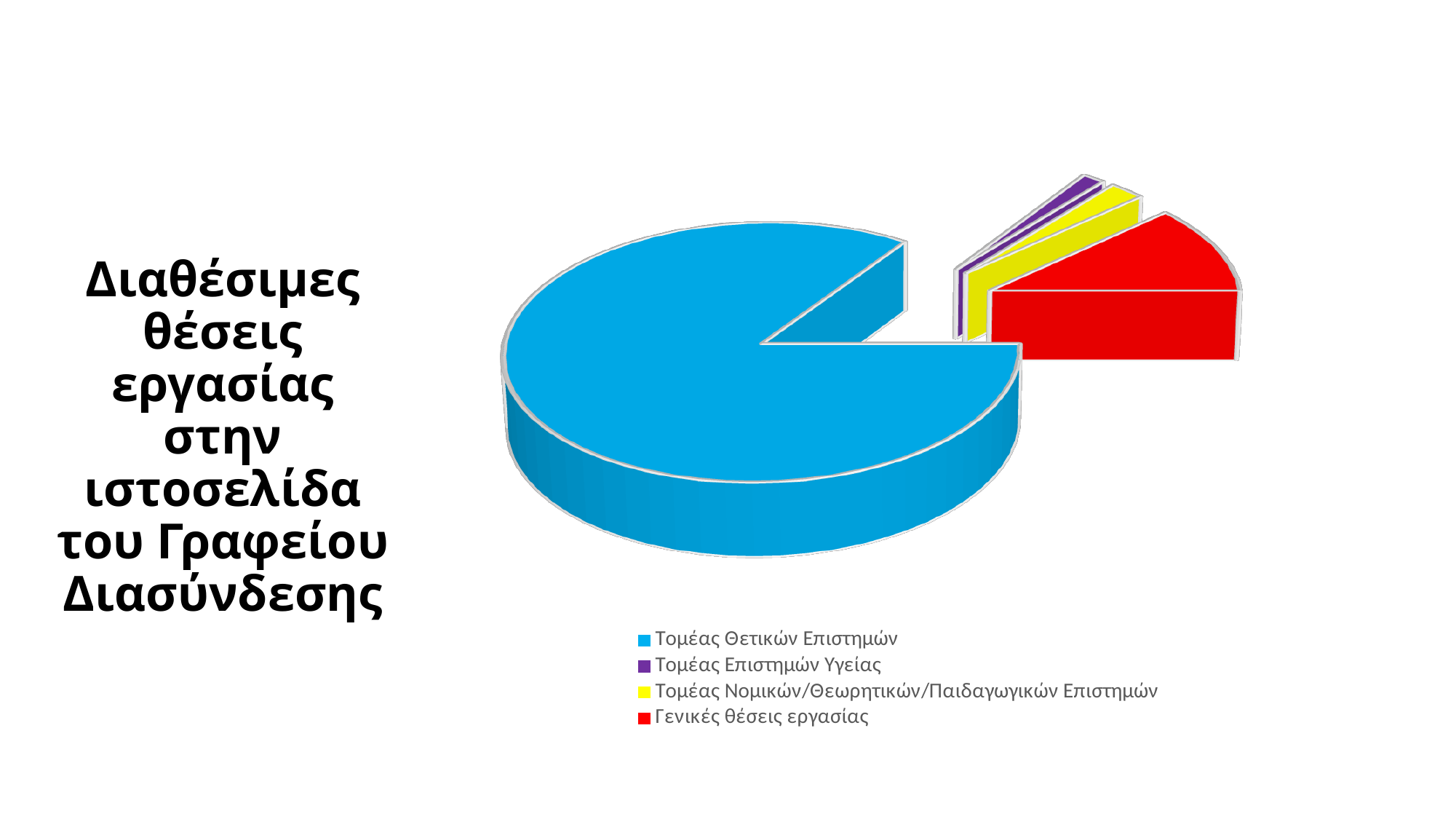
Which slice is larger: Γενικές θέσεις εργασίας or Τομέας Επιστημών Υγείας? Γενικές θέσεις εργασίας Which slice is larger: Γενικές θέσεις εργασίας or Τομέας Νομικών/Θεωρητικών/Παιδαγωγικών Επιστημών? Γενικές θέσεις εργασίας Which category has the largest slice of the pie? Τομέας Θετικών Επιστημών Which slice is larger: Τομέας Θετικών Επιστημών or Γενικές θέσεις εργασίας? Τομέας Θετικών Επιστημών What is the title text shown next to the pie chart? Διαθέσιμες θέσεις εργασίας στην ιστοσελίδα του Γραφείου Διασύνδεσης How many slices does the pie chart have? 4 What colour is the slice for Γενικές θέσεις εργασίας? Red What kind of chart is shown on the slide? Pie chart Which category has the smallest slice of the pie? Τομέας Επιστημών Υγείας